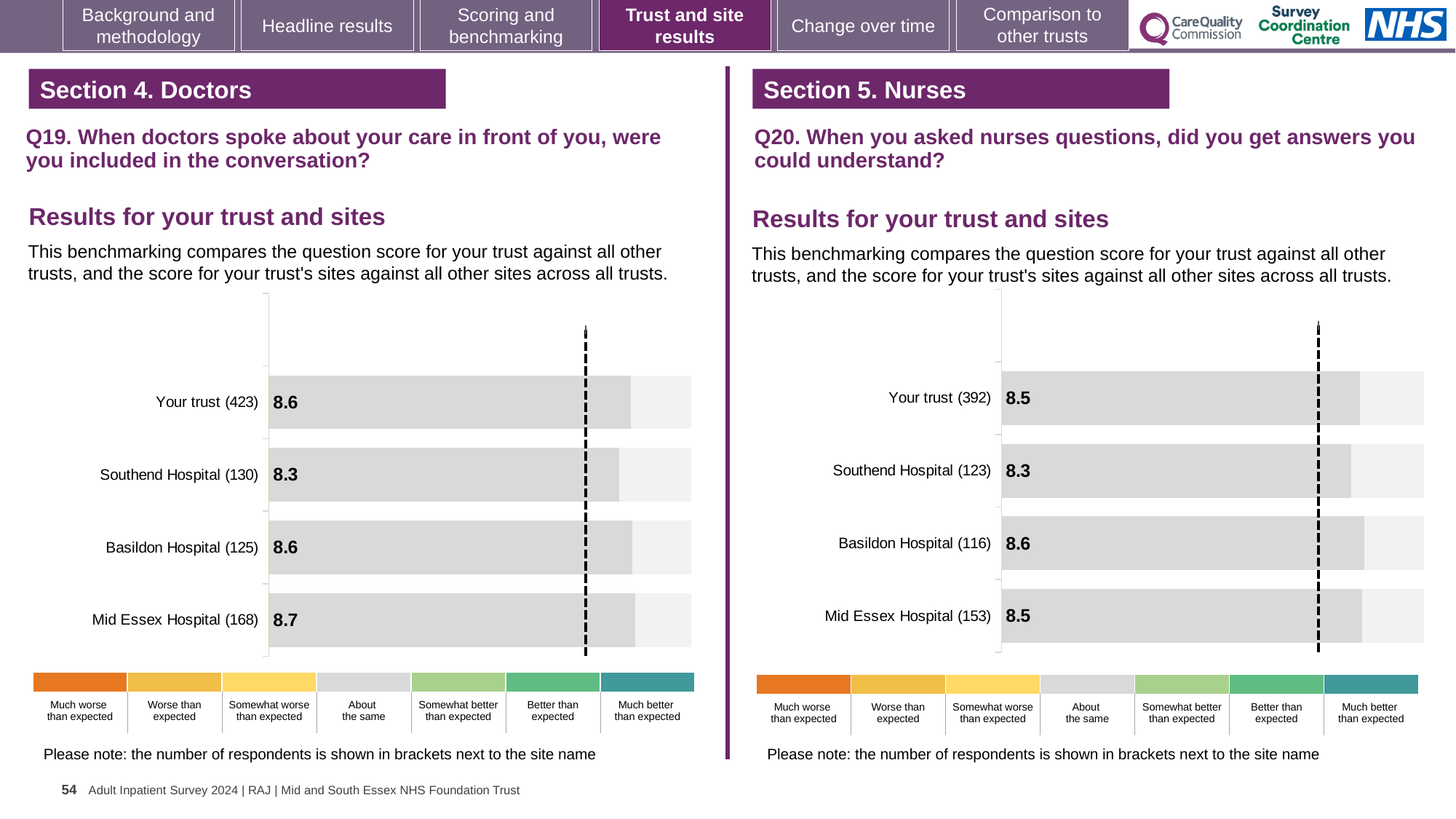
In the Q20 chart (Section 5. Nurses), what is the score for Your trust? 8.5 In the Q19 chart (Section 4. Doctors), which site has the lowest score? Southend Hospital How many bars are plotted in the Q20 chart (Section 5. Nurses)? 4 In the Q20 chart (Section 5. Nurses), what is the score for Basildon Hospital? 8.6 In the Q20 chart (Section 5. Nurses), which site has the lowest score? Southend Hospital In the Q19 chart (Section 4. Doctors), what is the score for Southend Hospital? 8.3 What kind of chart is used in the Q19 chart (Section 4. Doctors)? Bar chart In the Q19 chart (Section 4. Doctors), what is the difference between the scores for Mid Essex Hospital and Southend Hospital? 0.4 In the Q20 chart (Section 5. Nurses), which is larger, the score for Basildon Hospital or Southend Hospital? Basildon Hospital In the Q19 chart (Section 4. Doctors), how many respondents are shown in brackets for Basildon Hospital? 125 In the Q19 chart (Section 4. Doctors), what is the score for Your trust? 8.6 In the Q19 chart (Section 4. Doctors), which site has the highest score? Mid Essex Hospital